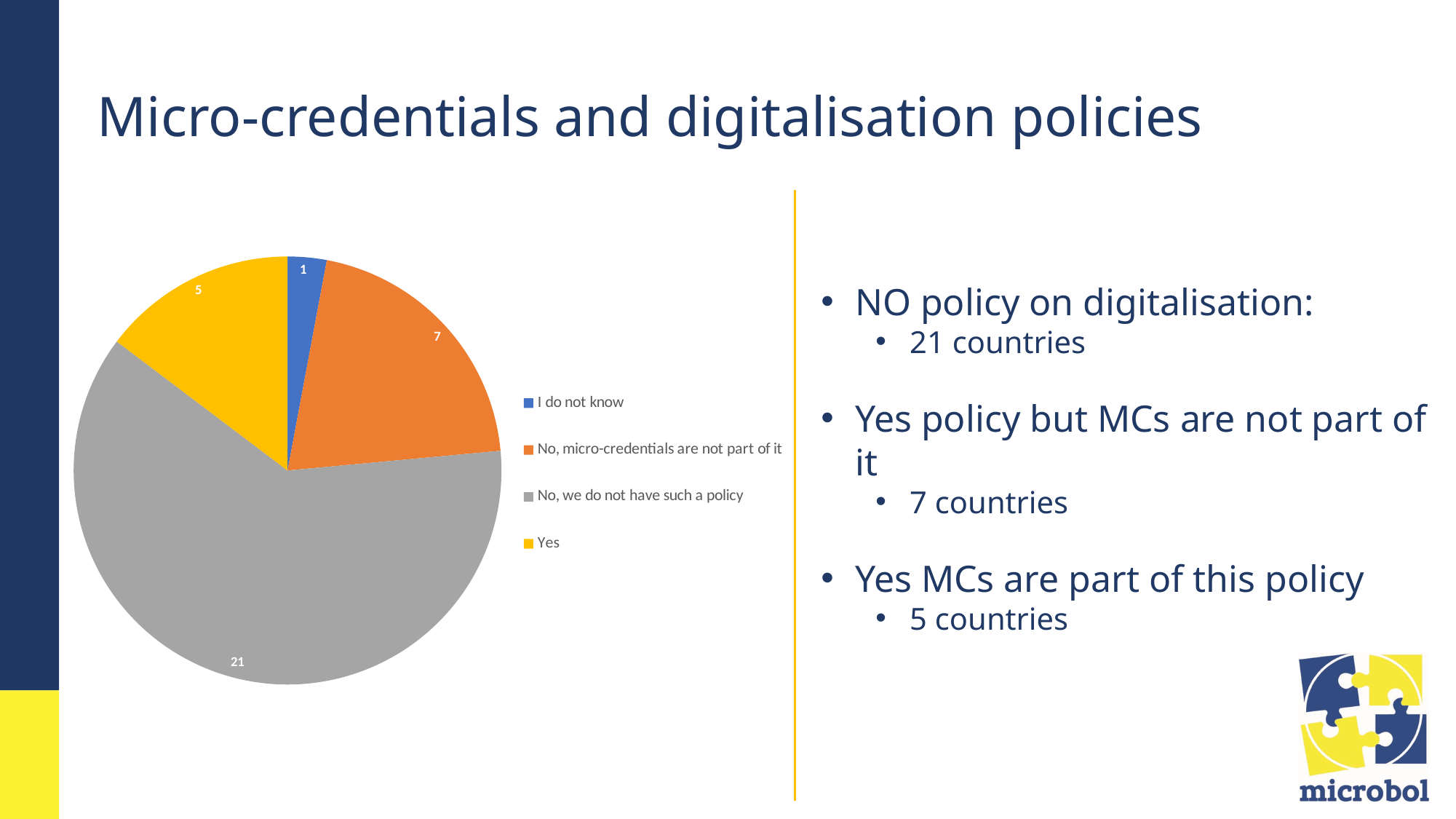
What is the total of all the values shown in the pie chart? 34 How many slices does the pie chart have? 4 Which is larger in the pie chart: "Yes" or "No, micro-credentials are not part of it"? No, micro-credentials are not part of it What is the value for "No, we do not have such a policy" in the pie chart? 21 What is the value for "No, micro-credentials are not part of it" in the pie chart? 7 Which category has the largest slice in the pie chart? No, we do not have such a policy What colour is the "Yes" slice in the pie chart? yellow Which category has the smallest slice in the pie chart? I do not know What is the difference between the values for "No, we do not have such a policy" and "No, micro-credentials are not part of it"? 14 What is the value for "I do not know" in the pie chart? 1 What is the value for "Yes" in the pie chart? 5 What kind of chart is shown on the slide? pie chart